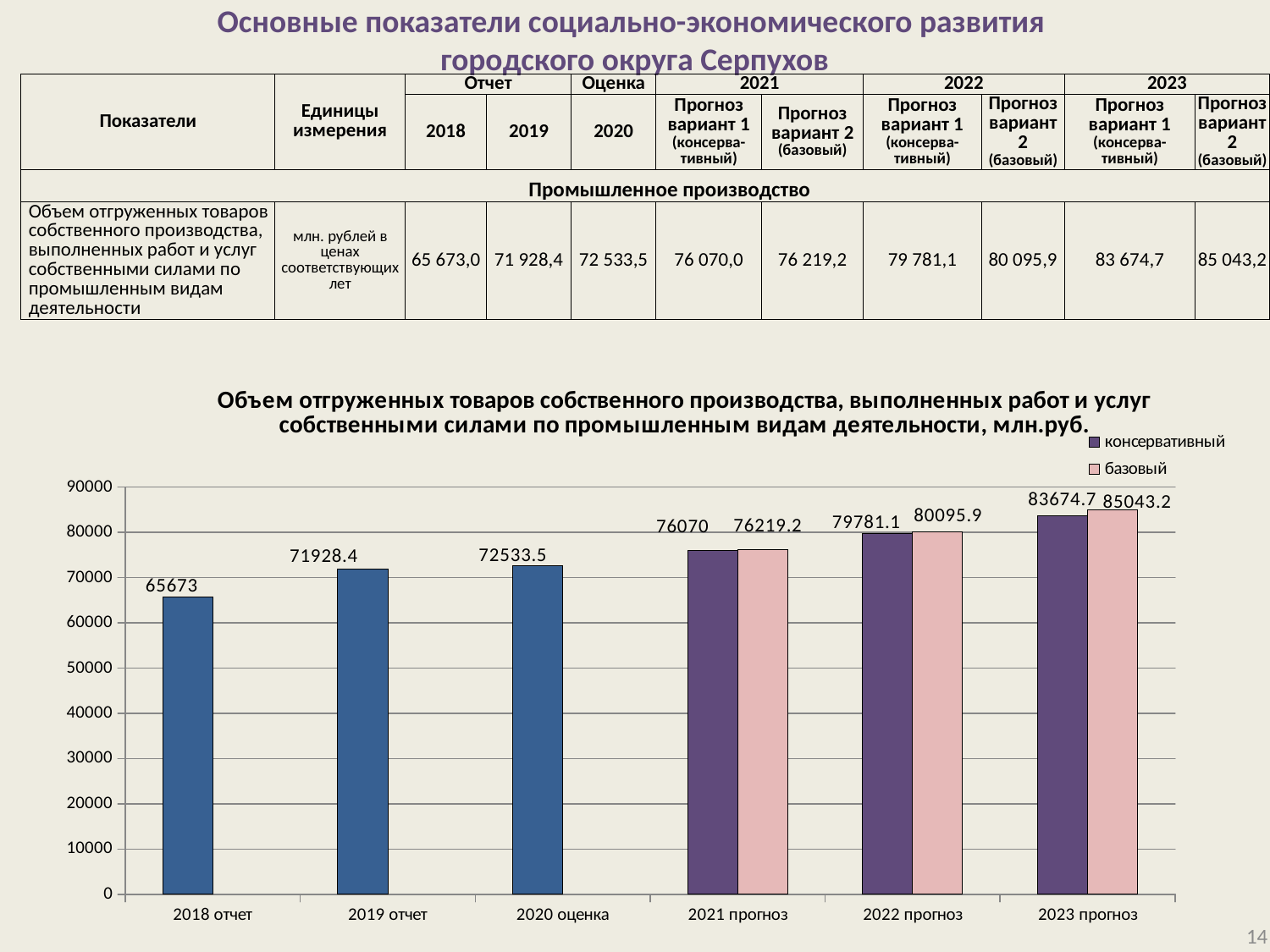
What is the value of the базовый series for 2022 прогноз? 80095.9 How many series does the chart legend list? 2 What is the value for 2018 отчет in the chart? 65673 Do the values in the chart rise or fall from 2018 отчет to 2023 прогноз? rise Which category has the lowest value in the chart? 2018 отчет Which is larger: the консервативный value for 2022 прогноз or the базовый value for 2021 прогноз? консервативный value for 2022 прогноз What kind of chart is shown on the slide? bar chart What is the difference between the базовый and консервативный values for 2021 прогноз? 149.2 What is the difference between the values for 2019 отчет and 2018 отчет? 6255.4 Which bar has the highest value in the chart? базовый for 2023 прогноз How many categories are shown on the x axis of the chart? 6 What is the value of the консервативный series for 2023 прогноз? 83674.7